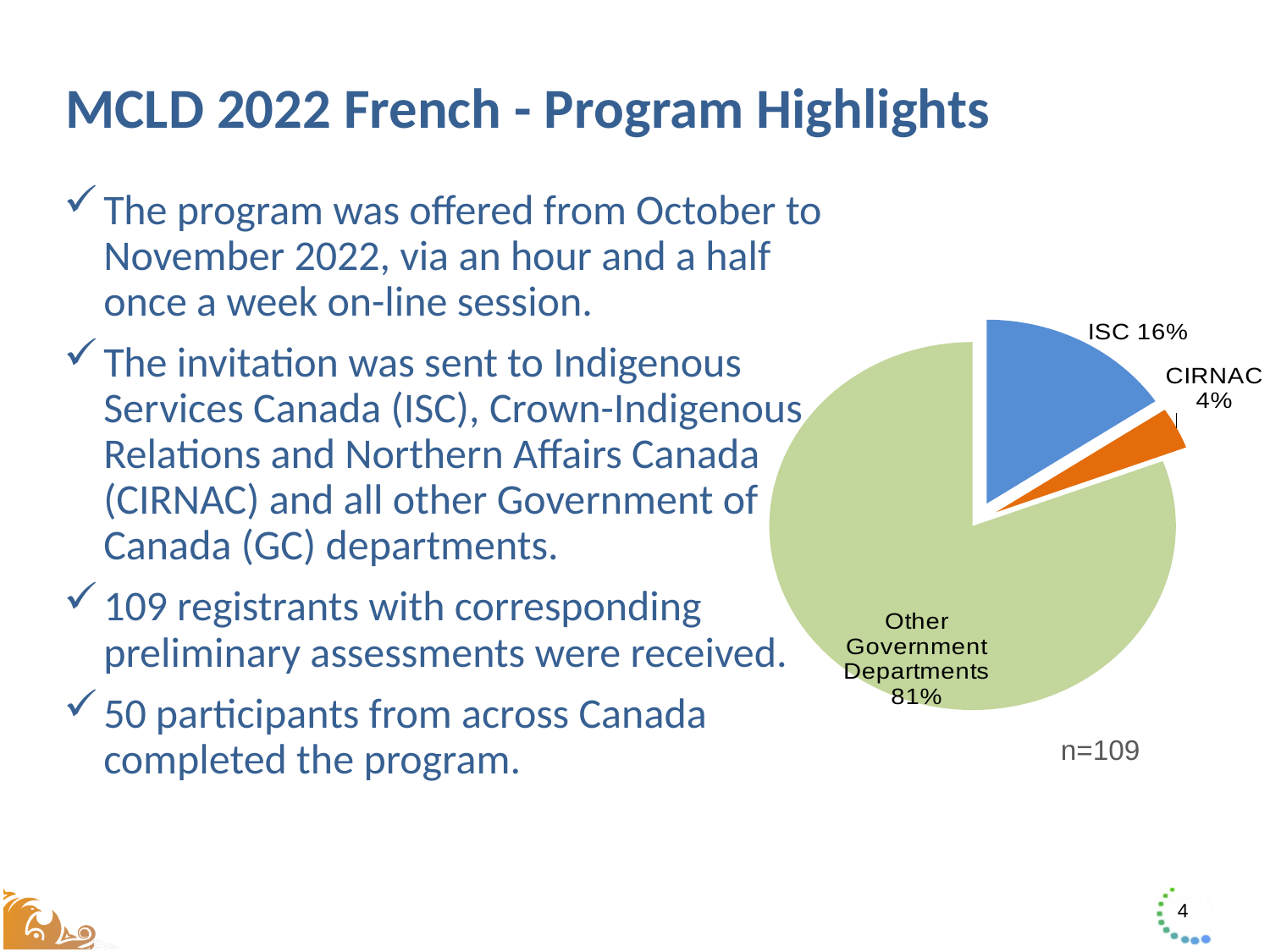
What share of the pie does CIRNAC represent? 4% Which slice of the pie chart is the smallest? CIRNAC What kind of chart is shown on the slide? pie chart Which is larger, the ISC slice or the CIRNAC slice? ISC Which slice of the pie chart is the largest? Other Government Departments What is the difference in percentage points between the Other Government Departments slice and the ISC slice? 65 What is the difference in percentage points between the ISC and CIRNAC slices? 12 How many slices does the pie chart have? 3 What share of the pie do Other Government Departments represent? 81% What colour is the Other Government Departments slice? green What share of the pie does ISC represent? 16% What is the value of n shown below the pie chart? n=109